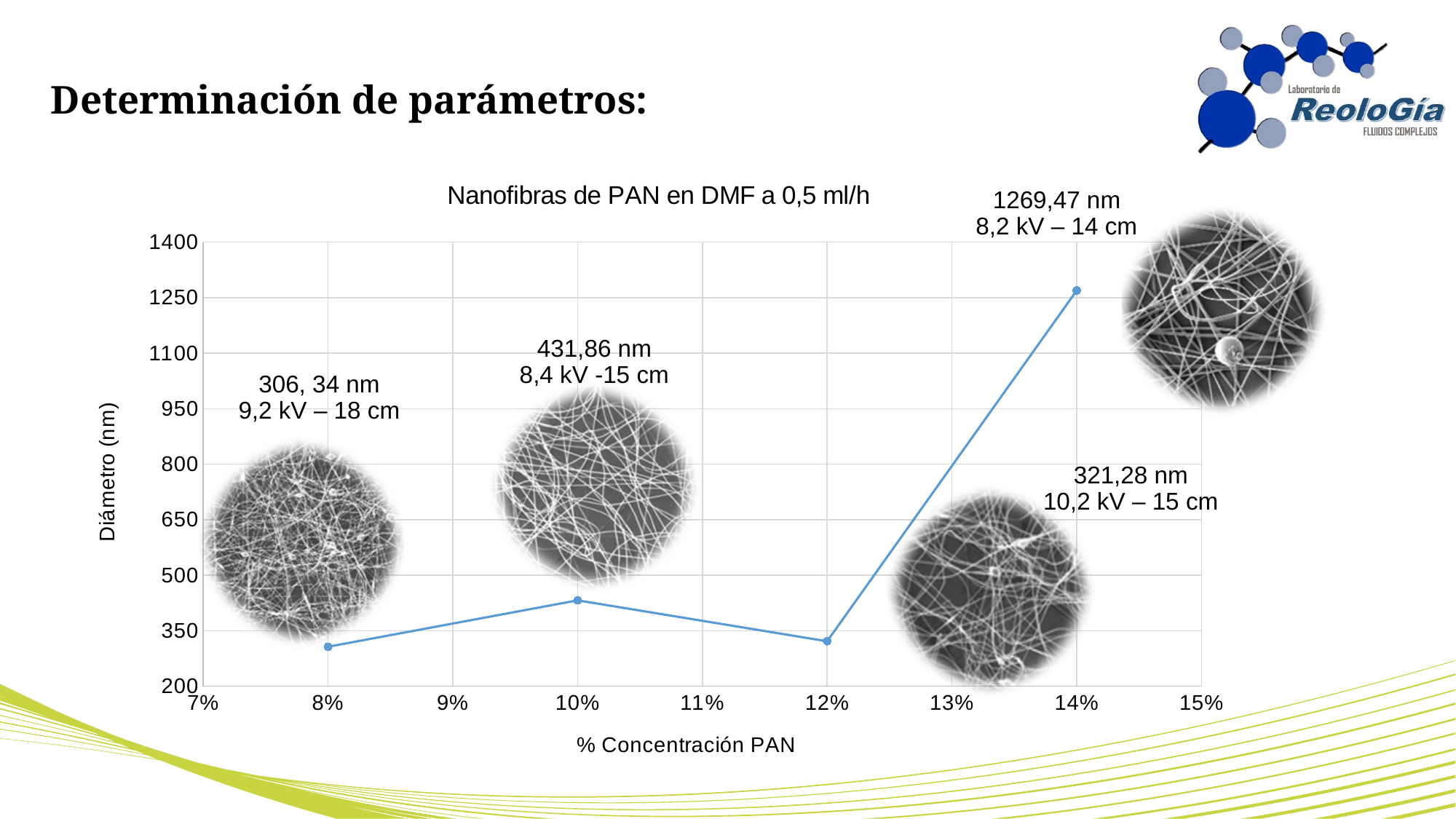
At which PAN concentration is the fibre diameter highest? 14% What is the difference in diameter between the 14% point and the 10% point? 837,61 nm How many data points are plotted on the line? 4 Is the diameter at 14% PAN concentration greater or less than 1100 nm? greater At which PAN concentration is the fibre diameter lowest? 8% What diameter is labelled for the point at 14% PAN concentration? 1269,47 nm What diameter is labelled for the point at 10% PAN concentration? 431,86 nm What kind of chart is shown on the slide? line chart Which has the larger diameter, the point at 10% or the point at 12%? 10% What diameter is labelled for the point at 12% PAN concentration? 321,28 nm What is the label of the y axis? Diámetro (nm) What is the title of the chart? Nanofibras de PAN en DMF a 0,5 ml/h